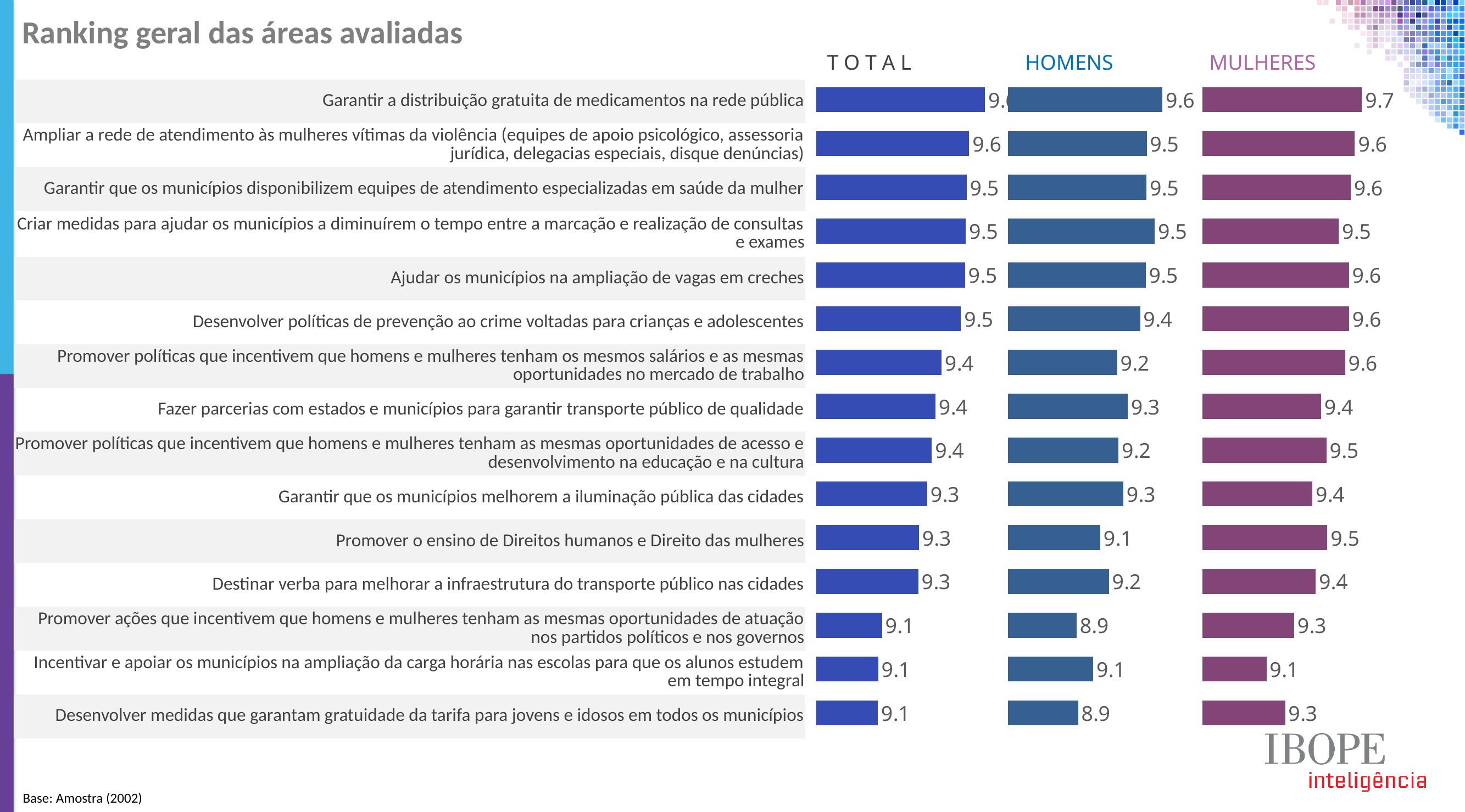
In the HOMENS chart, what is the value for "Promover políticas que incentivem que homens e mulheres tenham os mesmos salários e as mesmas oportunidades no mercado de trabalho"? 9.2 In the HOMENS chart, what is the value for "Garantir a distribuição gratuita de medicamentos na rede pública"? 9.6 For "Promover o ensino de Direitos humanos e Direito das mulheres", which is larger: the HOMENS value or the MULHERES value? MULHERES How many categories are shown in the TOTAL chart? 15 What is the title of the slide? Ranking geral das áreas avaliadas In the MULHERES chart, what is the value for "Garantir a distribuição gratuita de medicamentos na rede pública"? 9.7 In the MULHERES chart, what is the difference between the value for "Promover ações que incentivem que homens e mulheres tenham as mesmas oportunidades de atuação nos partidos políticos e nos governos" and the HOMENS value for the same category? 0.4 What kind of chart is used for the HOMENS data? Bar chart In the MULHERES chart, which category has the lowest value? Incentivar e apoiar os municípios na ampliação da carga horária nas escolas para que os alunos estudem em tempo integral In the MULHERES chart, which category has the highest value? Garantir a distribuição gratuita de medicamentos na rede pública In the TOTAL chart, what is the value for "Promover o ensino de Direitos humanos e Direito das mulheres"? 9.3 In the HOMENS chart, what is the difference between the value for "Garantir a distribuição gratuita de medicamentos na rede pública" and the value for "Desenvolver medidas que garantam gratuidade da tarifa para jovens e idosos em todos os municípios"? 0.7